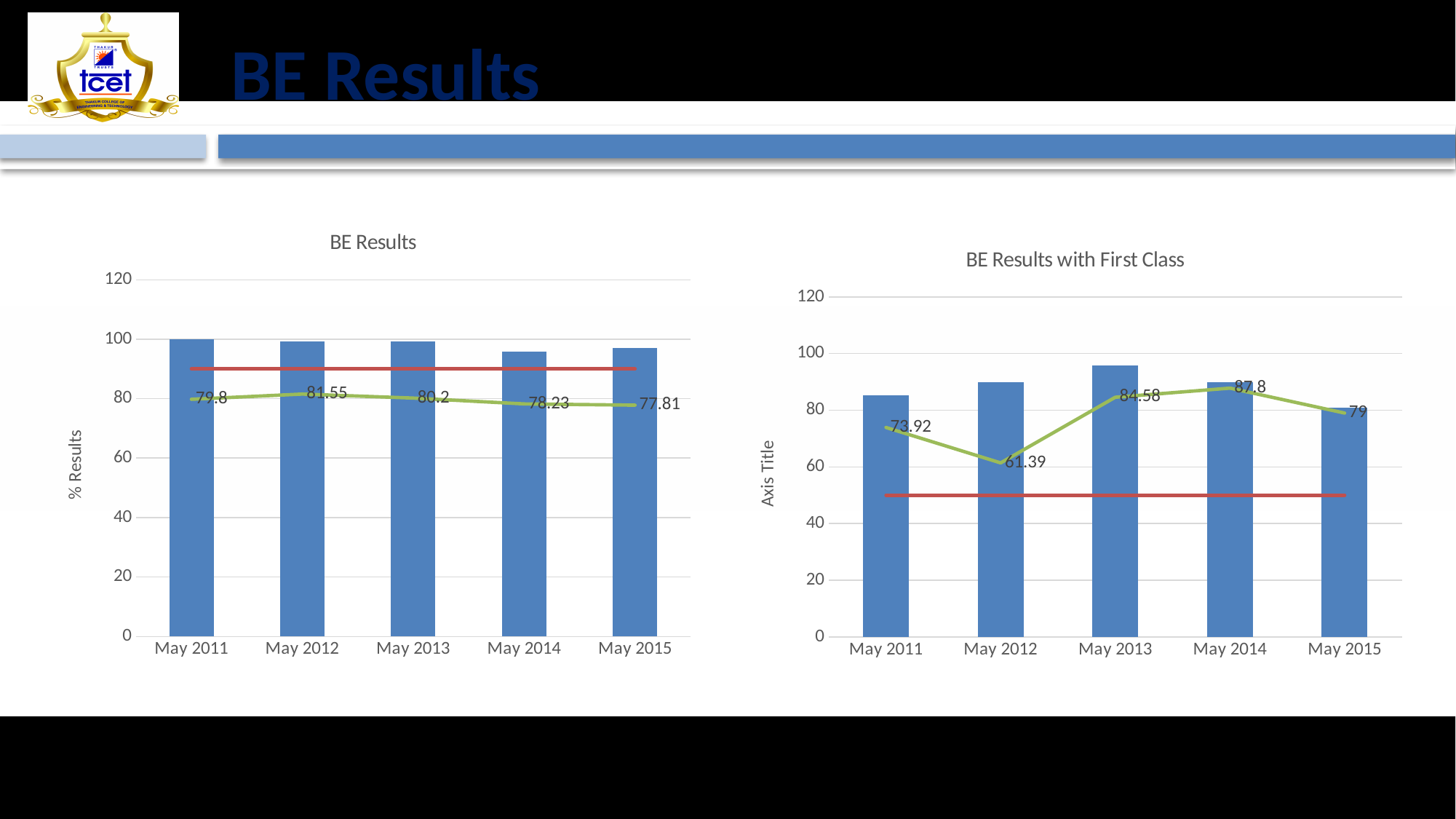
In the 'BE Results with First Class' chart, which year has the highest labelled line value? May 2014 In the 'BE Results with First Class' chart, what is the difference between the labelled line values for May 2014 and May 2012? 26.41 What is the label on the vertical axis of the 'BE Results' chart? % Results In the 'BE Results' chart, what is the labelled line value for May 2012? 81.55 How many years are shown on the x axis of the 'BE Results' chart? 5 In the 'BE Results' chart, what is the labelled line value for May 2015? 77.81 In the 'BE Results' chart, is the labelled line value for May 2011 or May 2014 larger? May 2011 In the 'BE Results with First Class' chart, what is the labelled line value for May 2013? 84.58 In the 'BE Results' chart, is the bar for May 2014 greater or less than 80? greater In the 'BE Results' chart, which year has the highest labelled line value? May 2012 In the 'BE Results with First Class' chart, which year has the lowest labelled line value? May 2012